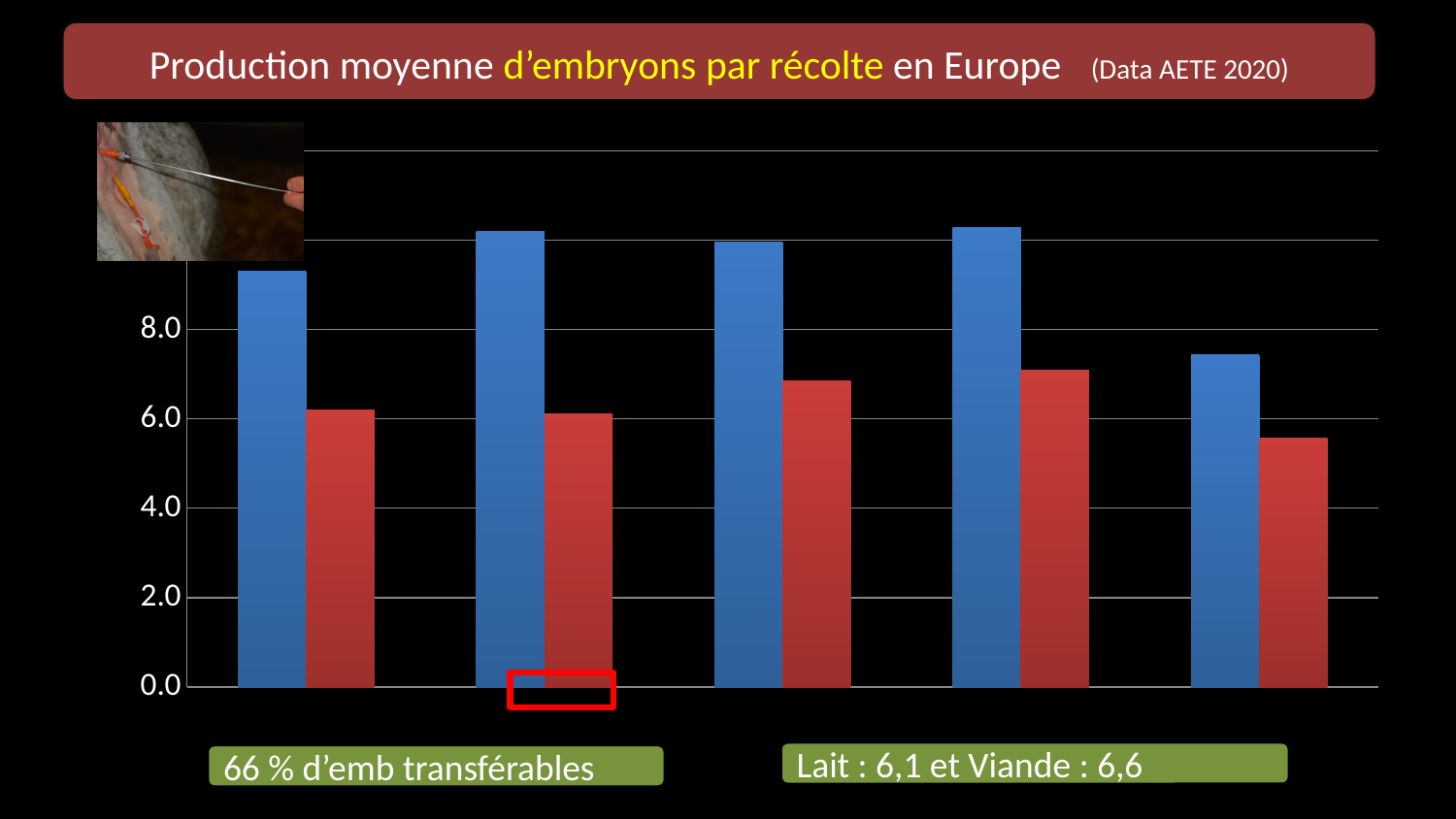
What kind of chart is shown on the slide? bar chart How many groups of bars are plotted in the chart? 5 What is the title of the chart on the slide? Production moyenne d'embryons par récolte en Europe In the fifth group from the left, is the blue bar or the red bar taller? the blue bar In the first group from the left, is the blue bar or the red bar taller? the blue bar What two colours are used for the bars in the chart? blue and red How many bars are there in each group of the chart? 2 Which group of bars, counting from the left, has the lowest red bar? the fifth group Is the value of the red bar in the fifth group from the left greater or less than 6.0? less Which group of bars, counting from the left, has the lowest blue bar? the fifth group Is the value of the blue bar in the fifth group from the left greater or less than 8.0? less Is the value of the blue bar in the first group from the left greater or less than 8.0? greater